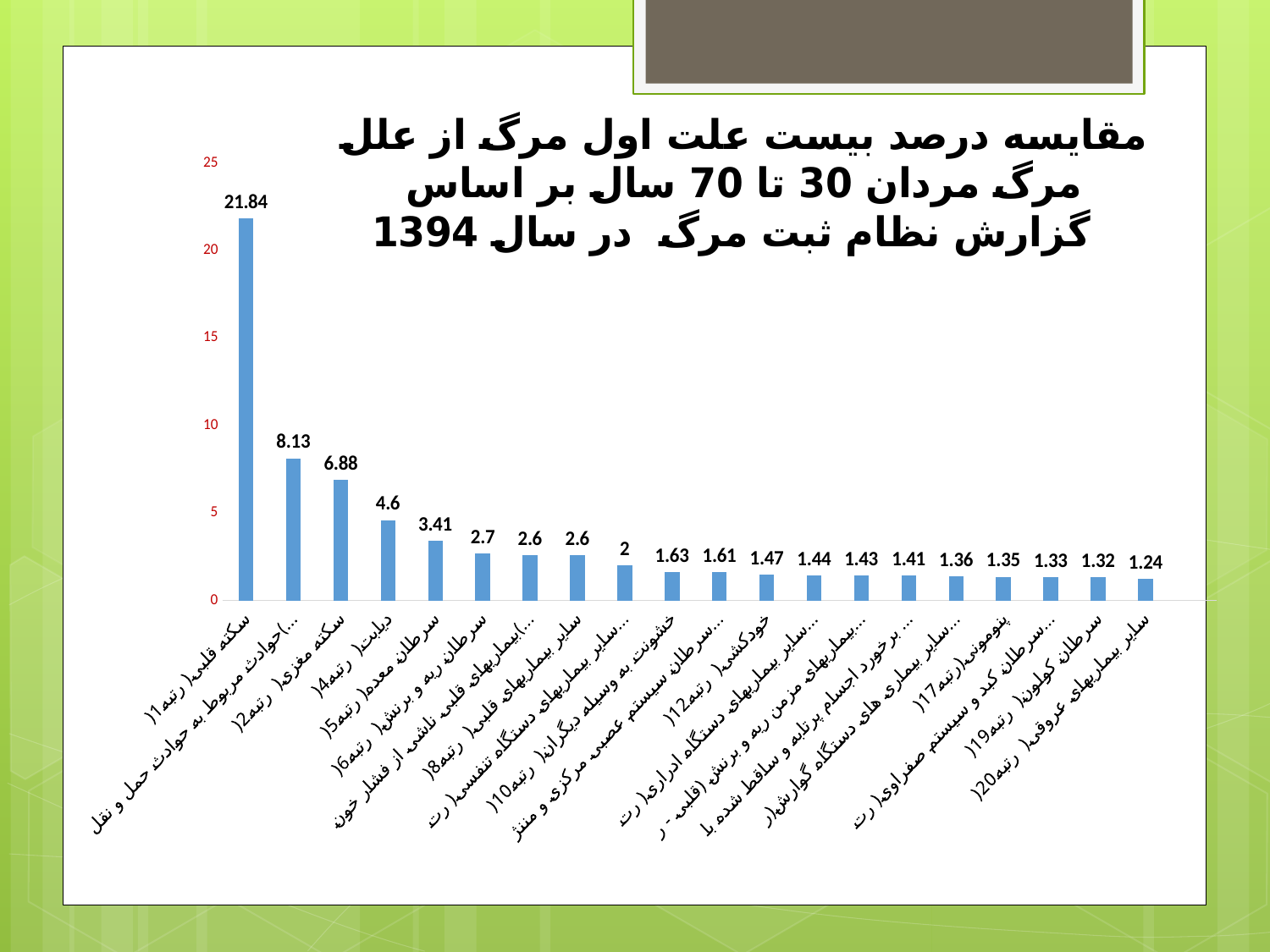
Which category has the highest value in the chart? سکته قلبی (رتبه 1) What is the value shown for خودکشی (رتبه 12)? 1.47 What is the value shown for the last bar, سایر بیماریهای عروقی (رتبه 20)? 1.24 What is the difference between the value for سکته قلبی (21.84) and the second bar (8.13)? 13.71 What is the value shown for دیابت (رتبه 4)? 4.6 Which category has the lowest value in the chart? سایر بیماریهای عروقی (رتبه 20) How many bars (causes of death) are plotted in the chart? 20 Do the values generally rise or fall from left to right along the x axis? fall What is the value shown for سکته قلبی (رتبه 1)? 21.84 What type of chart is shown on the slide? bar chart